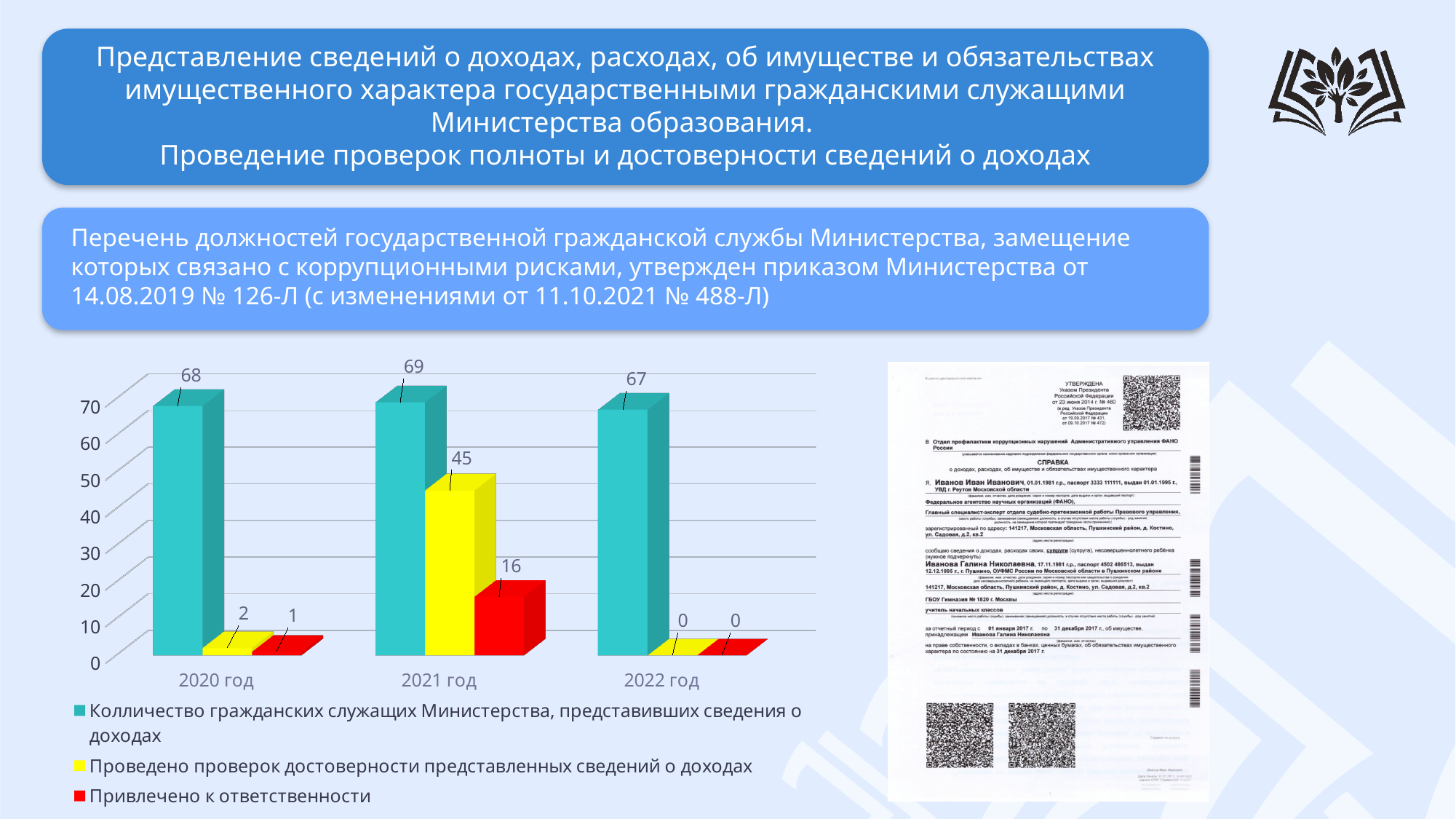
How many year categories are shown on the x axis of the chart? 3 What is the difference between the number of civil servants who submitted income information in 2021 год and in 2022 год? 2 In which year is the value for 'Привлечено к ответственности' the highest? 2021 год Which colour represents the series 'Привлечено к ответственности' in the chart? red What is the value for 'Проведено проверок достоверности представленных сведений о доходах' in 2021 год? 45 Which is larger: the value for 'Проведено проверок достоверности представленных сведений о доходах' in 2020 год or in 2021 год? 2021 год What type of chart is shown on the slide? bar chart What is the value for 'Колличество гражданских служащих Министерства, представивших сведения о доходах' in 2021 год? 69 What is the value for 'Проведено проверок достоверности представленных сведений о доходах' in 2022 год? 0 How many series does the chart legend list? 3 What is the value for 'Привлечено к ответственности' in 2020 год? 1 In which year is the value for 'Колличество гражданских служащих Министерства, представивших сведения о доходах' the highest? 2021 год